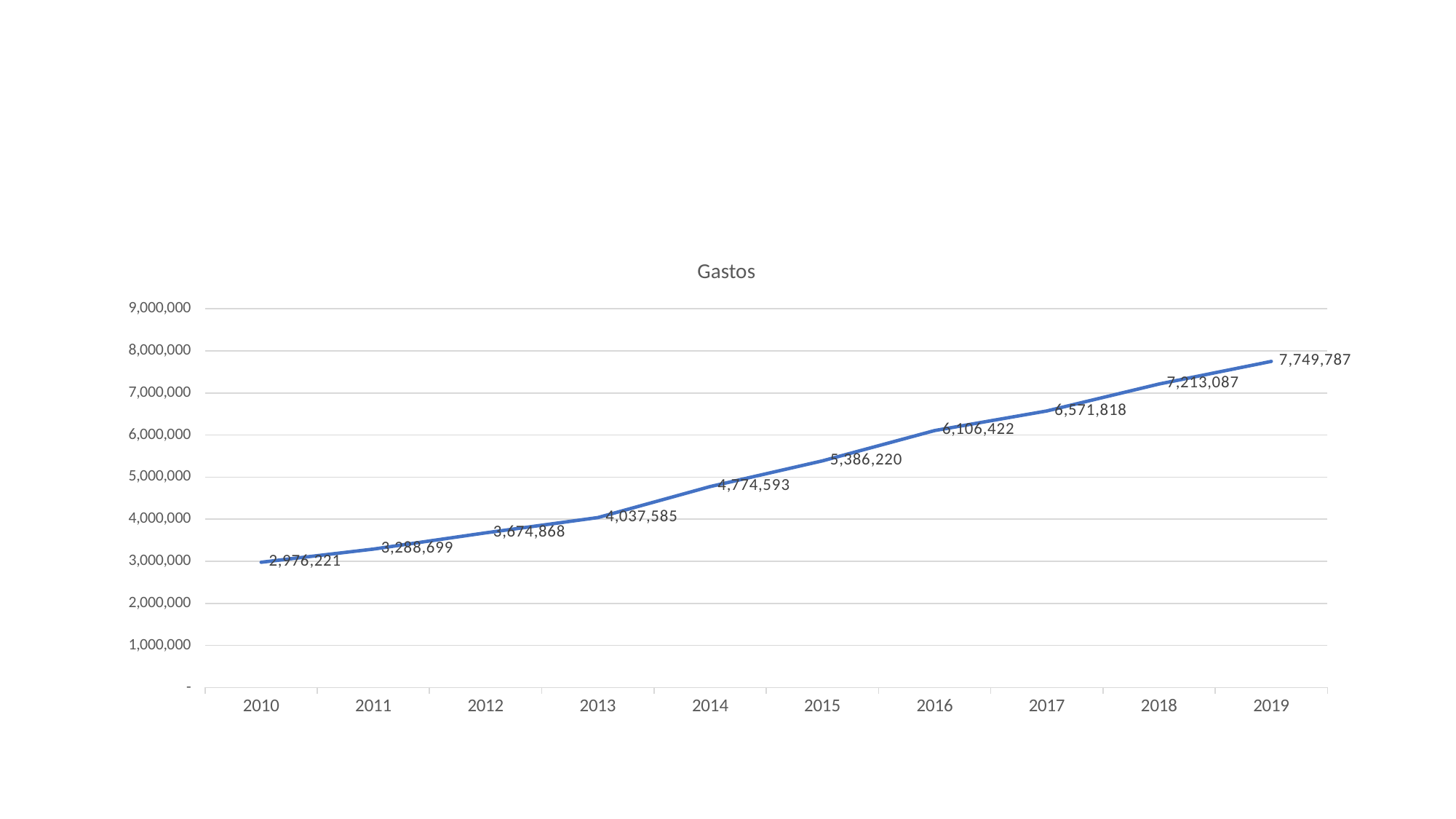
What is the difference between the 2019 and 2010 values in the Gastos chart? 4,773,566 What is the value for 2010 in the Gastos chart? 2,976,221 How many years are plotted in the Gastos chart? 10 Is the value for 2016 in the Gastos chart greater or less than 6,000,000? greater Which year has the highest value in the Gastos chart? 2019 Which year has the larger value in the Gastos chart, 2012 or 2017? 2017 What is the value for 2019 in the Gastos chart? 7,749,787 What kind of chart is shown on the slide? Line chart What is the difference between the 2014 and 2013 values in the Gastos chart? 737,008 What is the value for 2015 in the Gastos chart? 5,386,220 Which year has the lowest value in the Gastos chart? 2010 Do the values in the Gastos chart rise or fall from 2010 to 2019? Rise